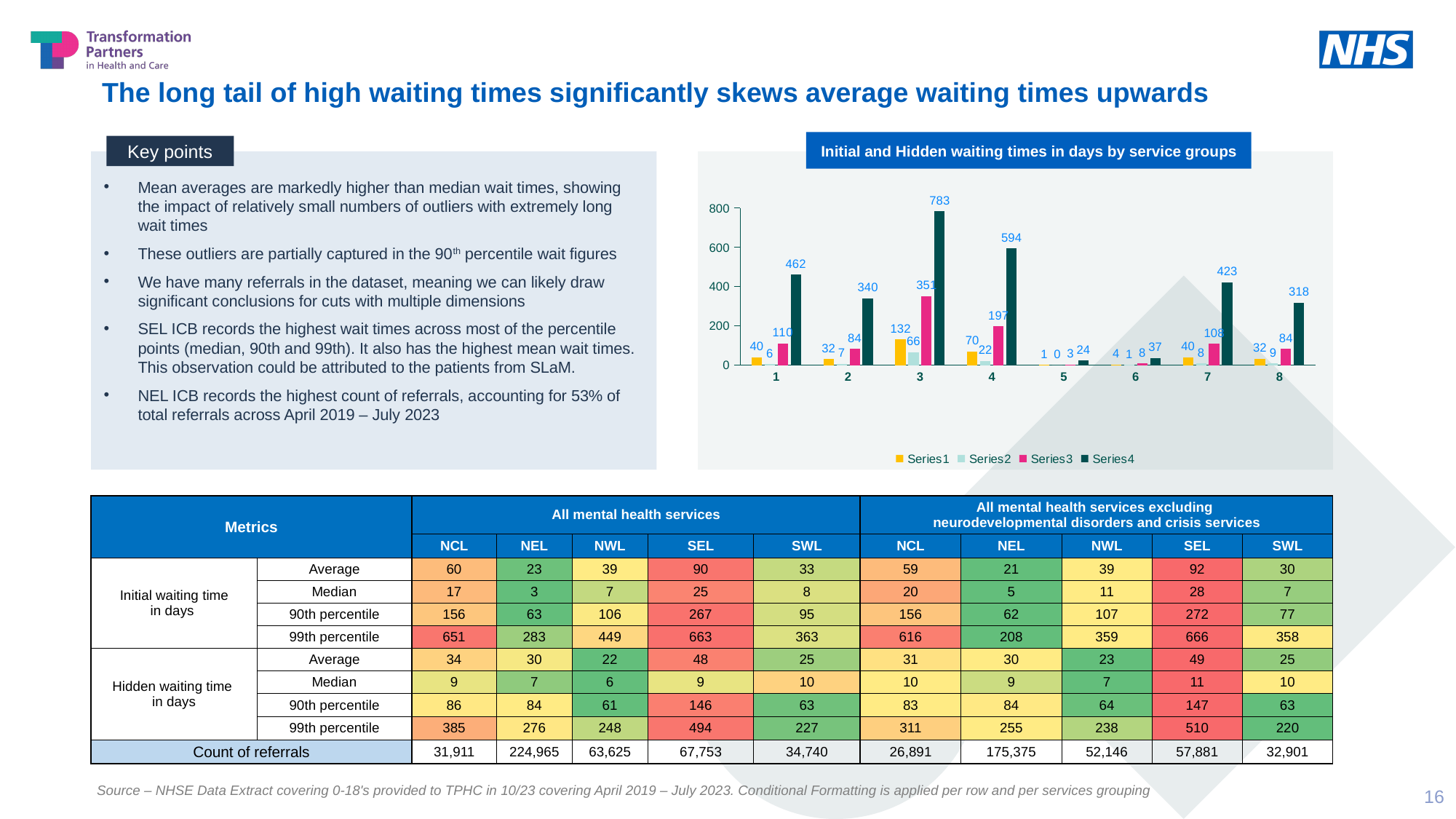
What is the value of Series1 for category 4 in the chart? 70 What is the title of the chart on the slide? Initial and Hidden waiting times in days by service groups How many categories are shown on the x axis of the chart? 8 Which category has the highest Series4 value in the chart? 3 What is the value of Series3 for category 1 in the chart? 110 What is the difference between the Series4 values for category 3 and category 4? 189 Which category has the lowest Series4 value in the chart? 5 What is the value of Series2 for category 3 in the chart? 66 What kind of chart is shown on the slide? Bar chart Which is larger in the chart: Series4 for category 7 or Series4 for category 8? Series4 for category 7 What is the value of Series4 for category 3 in the chart? 783 How many series does the chart legend list? 4